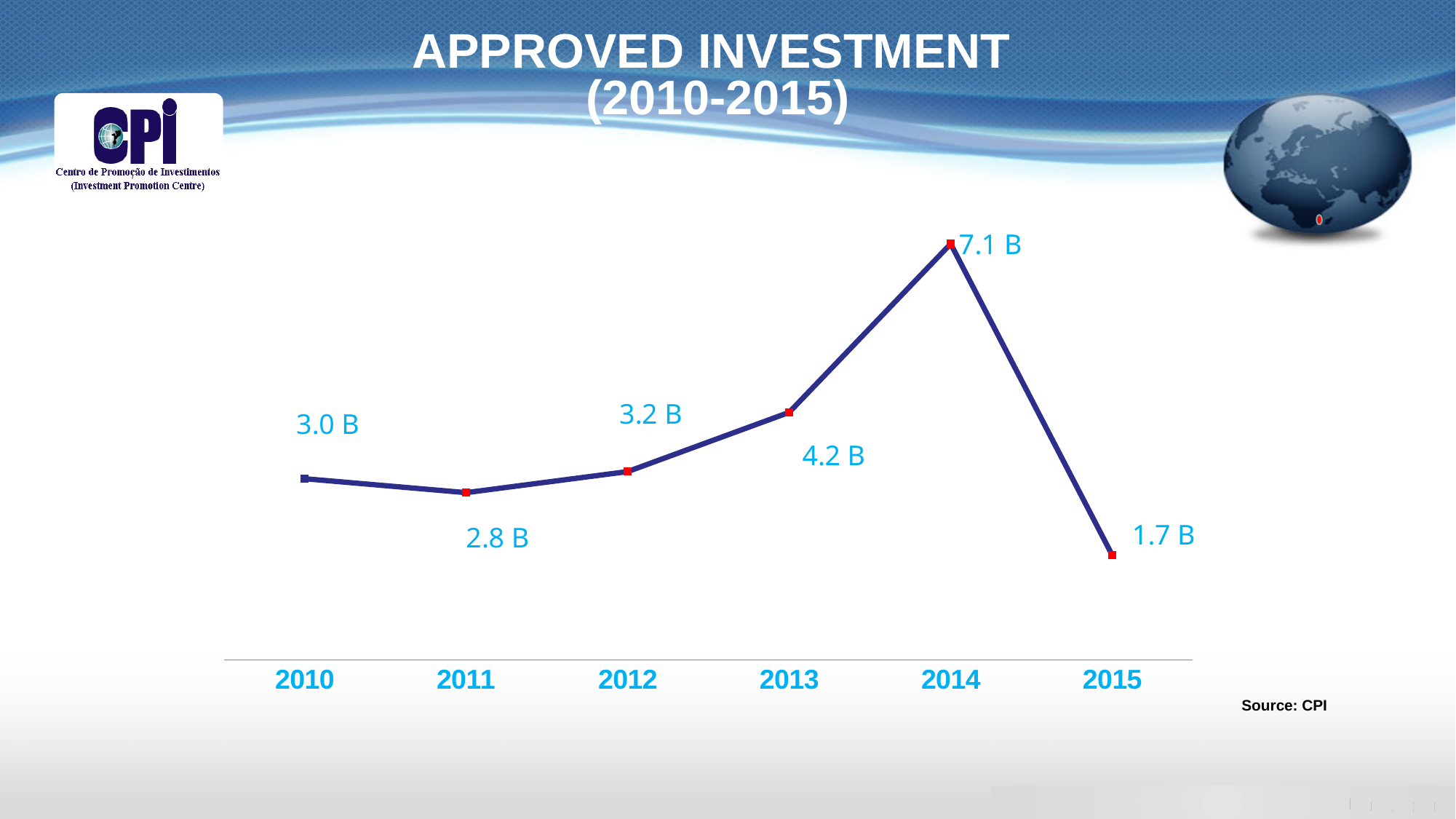
What is the approved investment value for 2014? 7.1 B What is the difference between the approved investment in 2014 and 2015? 5.4 B Which year has the lowest approved investment? 2015 What kind of chart is shown on the slide? Line chart What is the approved investment value for 2013? 4.2 B What is the approved investment value for 2015? 1.7 B What is the difference between the approved investment in 2012 and 2011? 0.4 B What is the approved investment value for 2010? 3.0 B Which year has a larger approved investment, 2013 or 2012? 2013 How many years are plotted on the chart? 6 Does the approved investment rise or fall from 2014 to 2015? Fall Which year has the highest approved investment? 2014